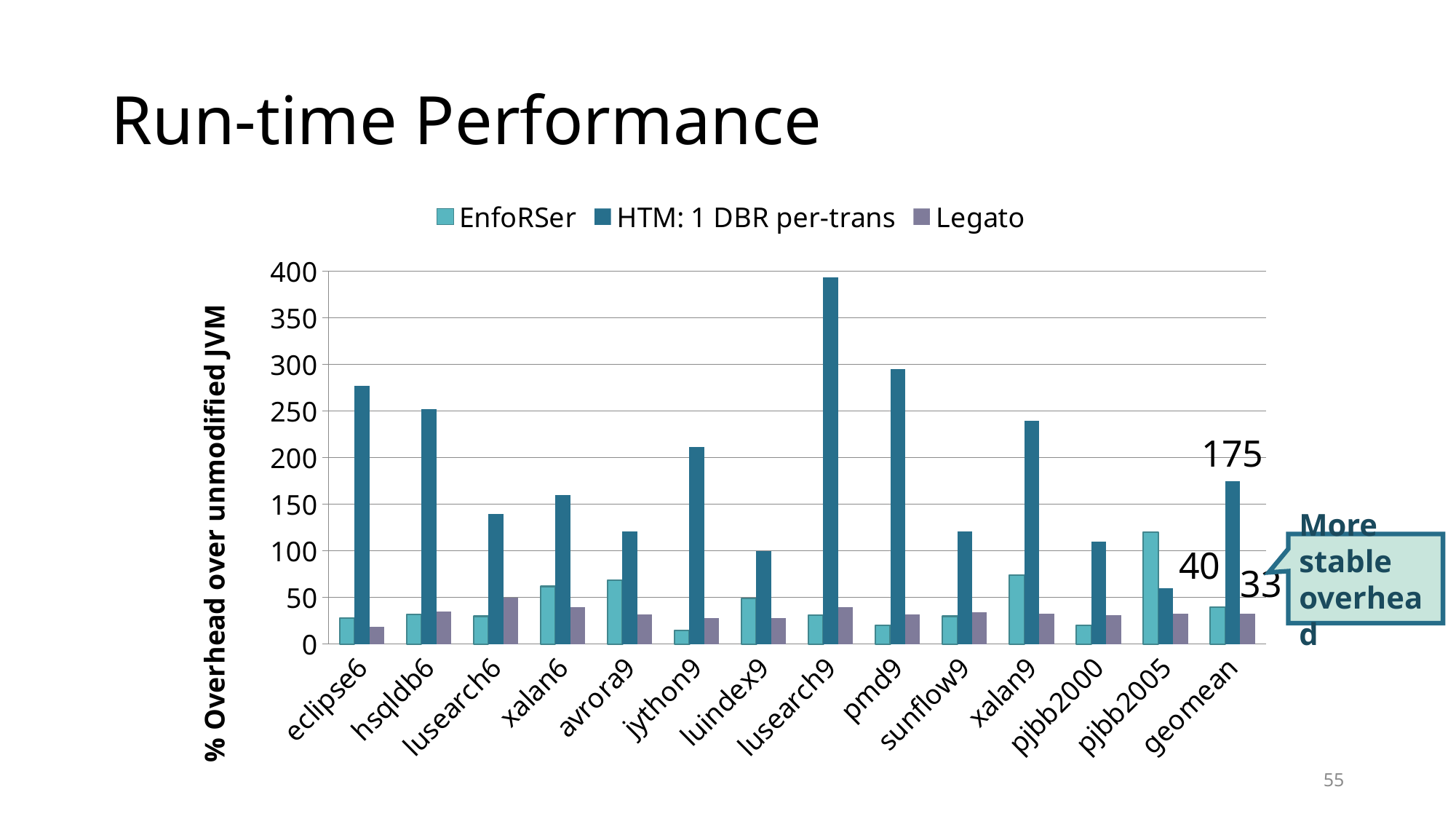
How many benchmark categories are shown on the x axis? 14 What is the label of the y axis? % Overhead over unmodified JVM What is the EnfoRSer value for geomean? 40 What kind of chart is shown on the slide? bar chart Is the HTM: 1 DBR per-trans value for lusearch9 greater or less than 350? greater What is the Legato value for geomean? 33 For pjbb2005, which is larger: the EnfoRSer value or the HTM: 1 DBR per-trans value? EnfoRSer How many series does the legend list? 3 Which benchmark has the highest HTM: 1 DBR per-trans value? lusearch9 What is the HTM: 1 DBR per-trans value for geomean? 175 What is the difference between the HTM: 1 DBR per-trans and EnfoRSer values for geomean? 135 Which benchmark has the lowest HTM: 1 DBR per-trans value? pjbb2005